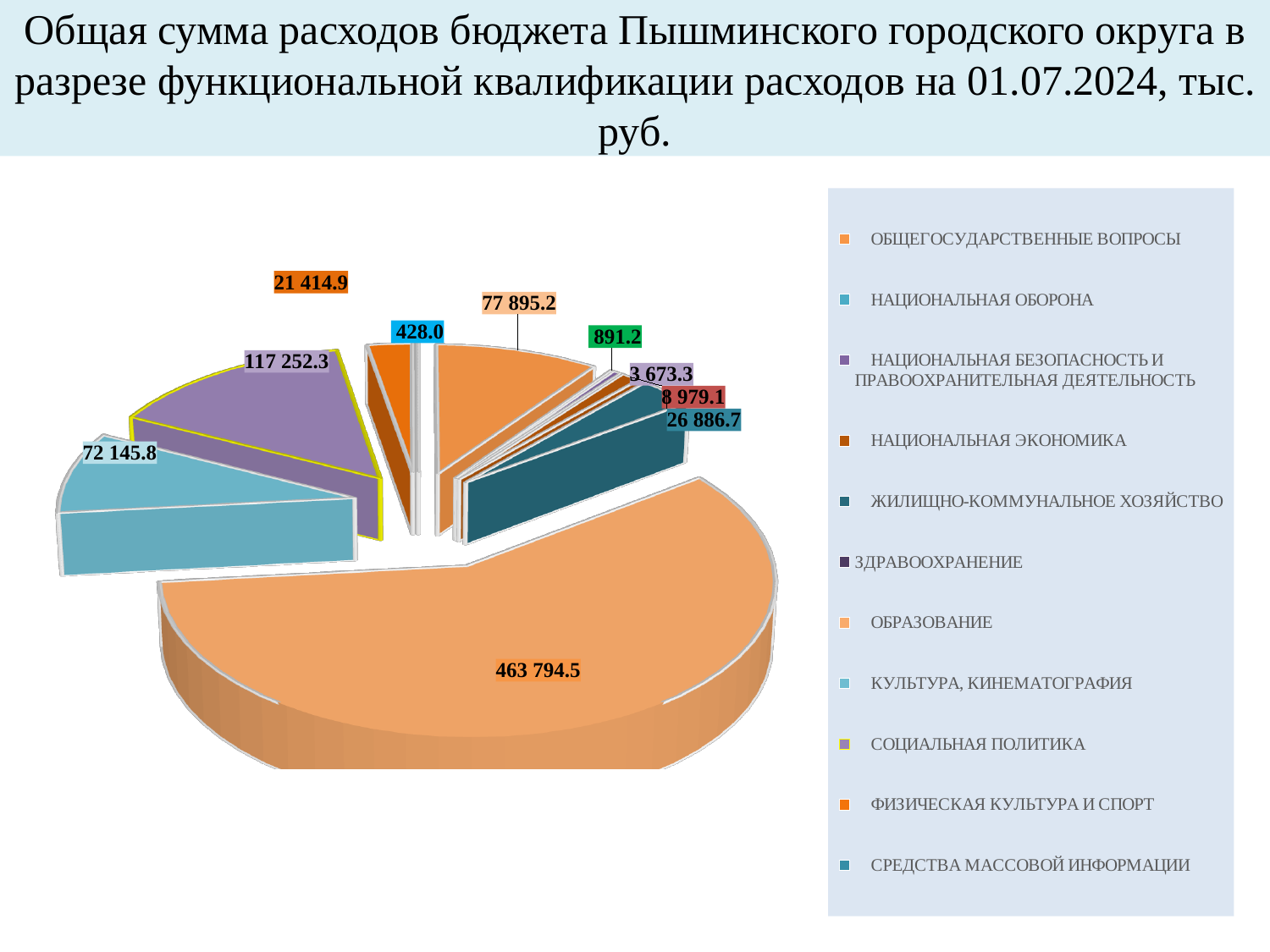
What is the largest value shown on the pie chart? 463 794.5 What is the difference between the value for СОЦИАЛЬНАЯ ПОЛИТИКА and the value for КУЛЬТУРА, КИНЕМАТОГРАФИЯ? 45 106.5 Which is larger, the value for СОЦИАЛЬНАЯ ПОЛИТИКА or the value for КУЛЬТУРА, КИНЕМАТОГРАФИЯ? СОЦИАЛЬНАЯ ПОЛИТИКА What is the value for КУЛЬТУРА, КИНЕМАТОГРАФИЯ? 72 145.8 What is the value for ЖИЛИЩНО-КОММУНАЛЬНОЕ ХОЗЯЙСТВО? 26 886.7 In what units are the values on the chart expressed, according to the slide title? тыс. руб. What is the value for ФИЗИЧЕСКАЯ КУЛЬТУРА И СПОРТ? 21 414.9 How many categories does the legend of the pie chart list? 11 What is the smallest value labelled on the pie chart? 428.0 What is the value for СОЦИАЛЬНАЯ ПОЛИТИКА? 117 252.3 What kind of chart is shown on the slide? pie chart Which category has the largest slice in the pie chart? ОБРАЗОВАНИЕ